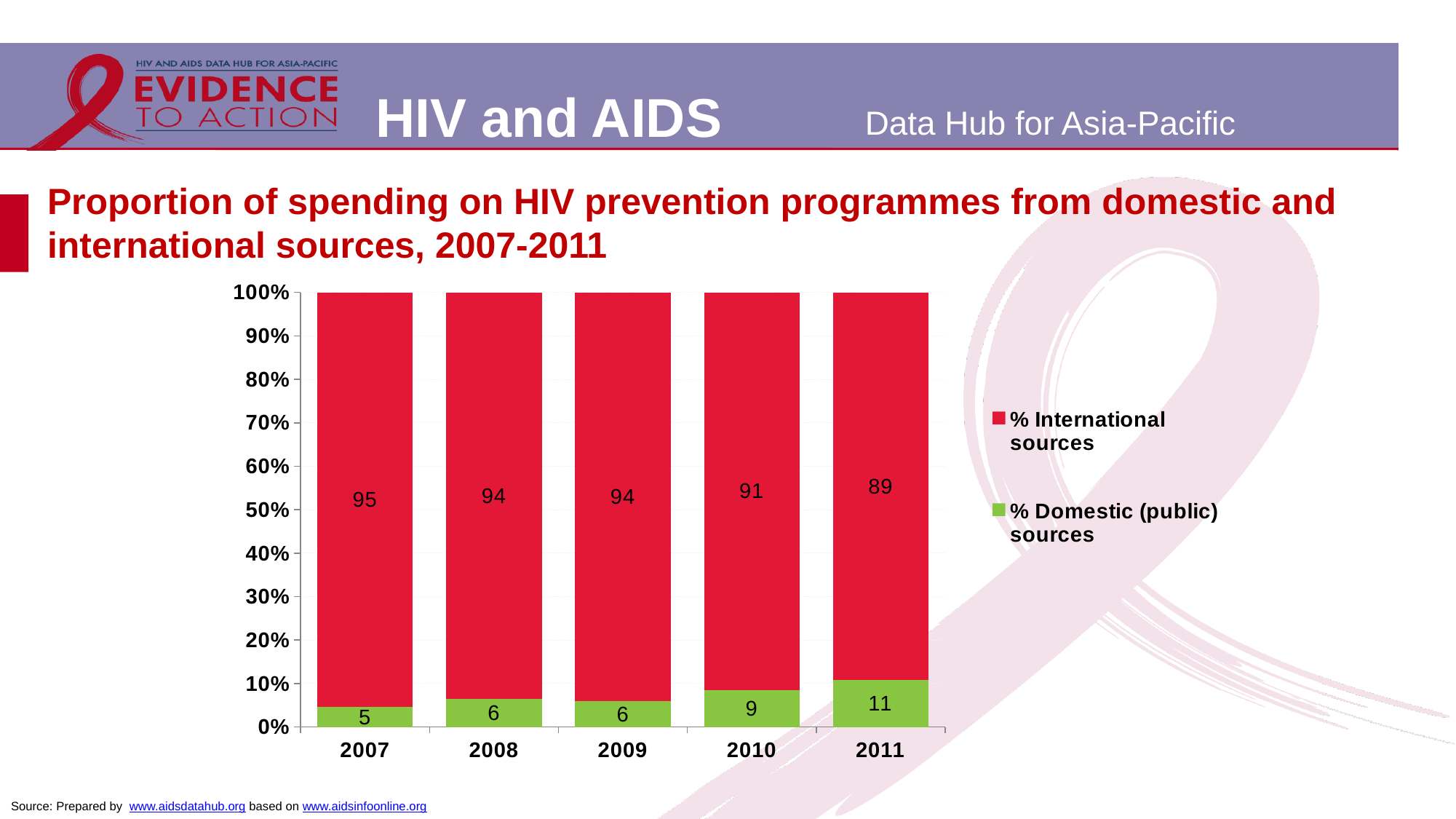
Which is larger, the % Domestic (public) sources value for 2008 or for 2010? 2010 How many years are shown on the x axis? 5 Does the value for % Domestic (public) sources rise or fall from 2007 to 2011? Rise Which year has the lowest value for % International sources? 2011 What is the value for % Domestic (public) sources in 2010? 9 What is the value for % Domestic (public) sources in 2011? 11 What kind of chart is shown on the slide? Stacked bar chart How many series does the legend list? 2 What is the value for % International sources in 2007? 95 What is the value for % International sources in 2009? 94 Which year has the highest value for % Domestic (public) sources? 2011 What is the difference between the % International sources values for 2007 and 2011? 6